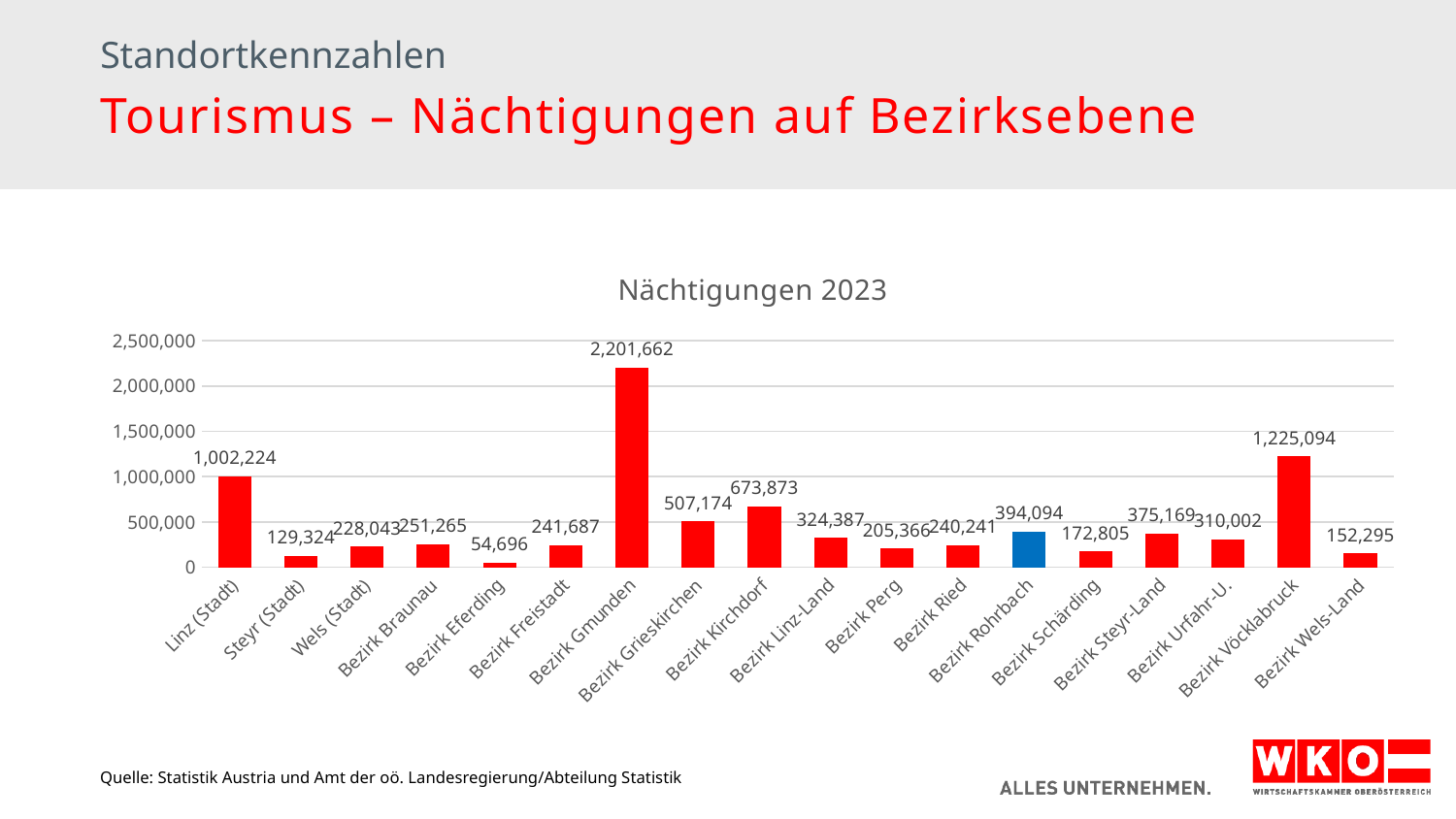
Which is larger, Bezirk Kirchdorf or Bezirk Grieskirchen? Bezirk Kirchdorf Which category has the lowest value? Bezirk Eferding What is the value for Bezirk Gmunden? 2,201,662 What is the value for Bezirk Eferding? 54,696 Which category has the highest value? Bezirk Gmunden Is the value for Linz (Stadt) greater or less than 1,000,000? greater Which bar is coloured blue instead of red? Bezirk Rohrbach What is the value for Bezirk Rohrbach? 394,094 What kind of chart is this? bar chart How many categories are shown on the x axis? 18 What is the difference between Bezirk Gmunden and Bezirk Vöcklabruck? 976,568 What is the value for Bezirk Vöcklabruck? 1,225,094